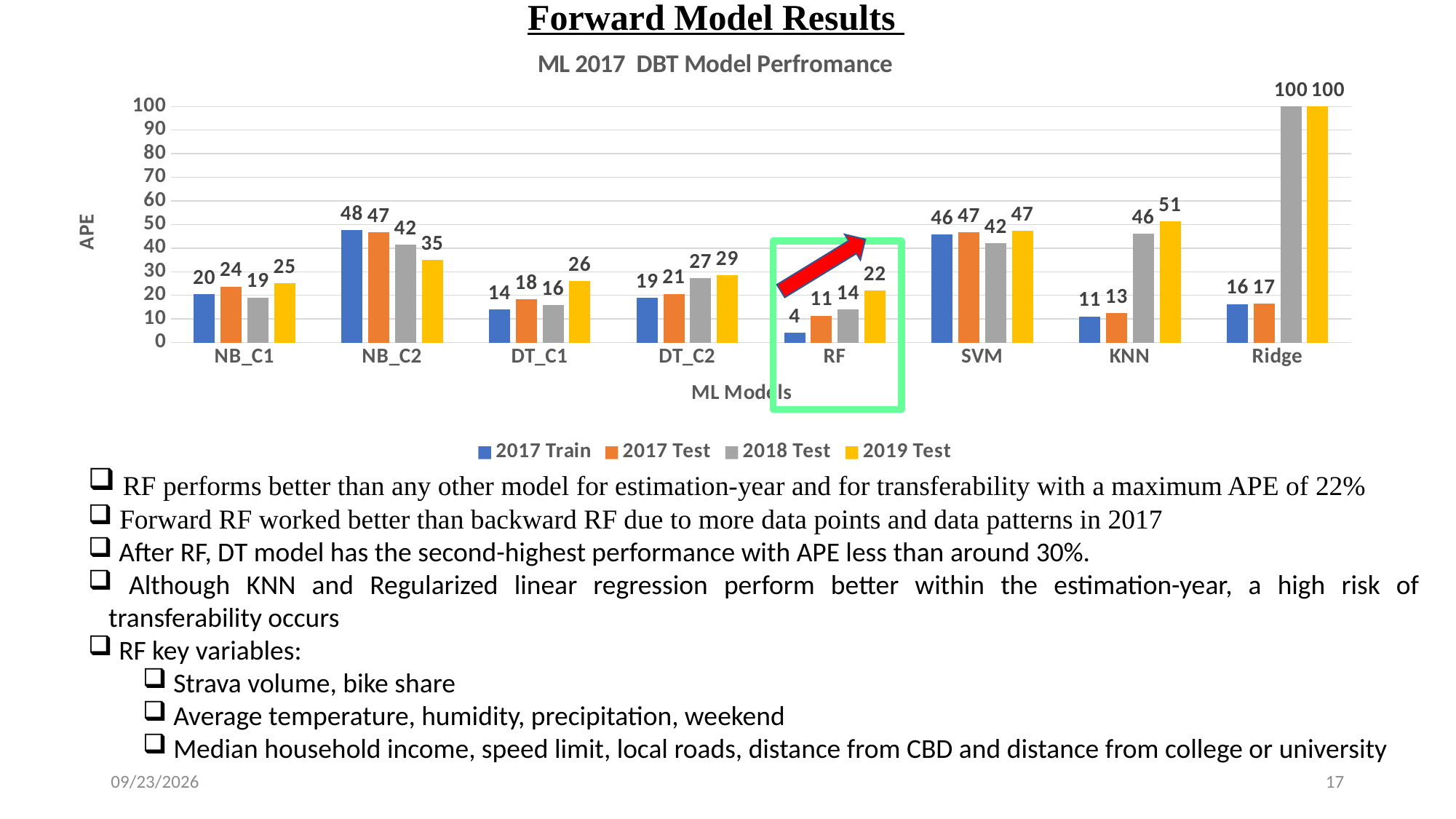
What is the 2017 Train APE value for RF? 4 What type of chart is shown on the slide? bar chart How many ML models (categories) are shown on the x axis? 8 Which model has the highest 2019 Test APE? Ridge Which is larger, the 2018 Test APE for KNN or the 2018 Test APE for SVM? KNN What is the title of the chart? ML 2017 DBT Model Perfromance What is the difference between the 2019 Test APE and the 2017 Train APE for RF? 18 What is the 2018 Test APE value for NB_C2? 42 What is the 2019 Test APE value for KNN? 51 Which model has the lowest 2017 Train APE? RF How many series does the legend list? 4 What is the label of the y axis? APE